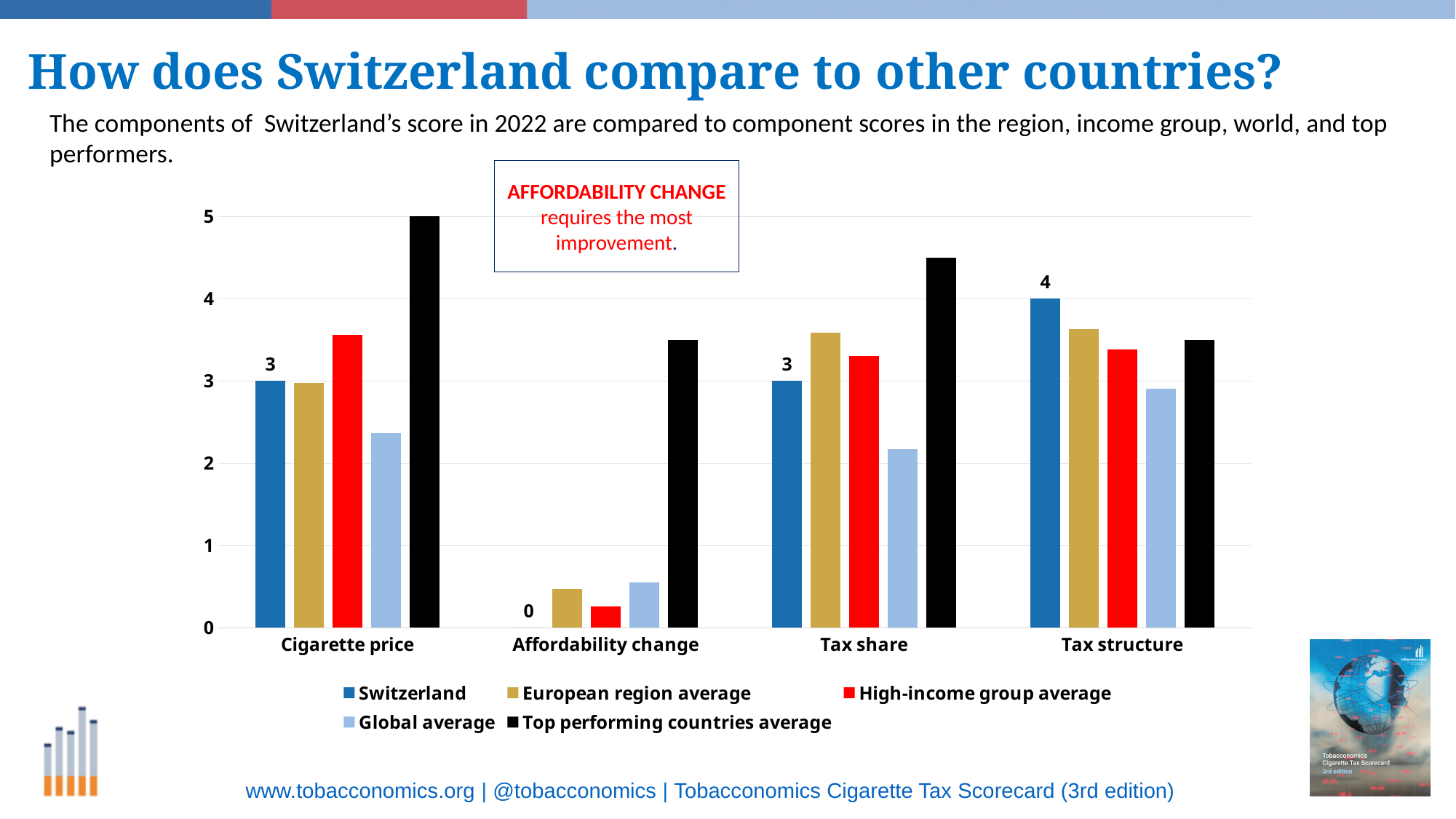
Is the Top performing countries average for Tax share greater or less than 4? greater How many series does the legend list? 5 For Cigarette price, which is larger: Switzerland's score or the Top performing countries average? Top performing countries average What is the Top performing countries average score for Cigarette price? 5 On which component does Switzerland have its lowest score? Affordability change What is Switzerland's score for Affordability change? 0 What is Switzerland's score for Tax structure? 4 What is Switzerland's score for Cigarette price? 3 How much higher is Switzerland's Tax structure score than its Cigarette price score? 1 Is the Global average for Cigarette price greater or less than 3? less On which component does Switzerland have its highest score? Tax structure How many score components are shown on the x axis? 4